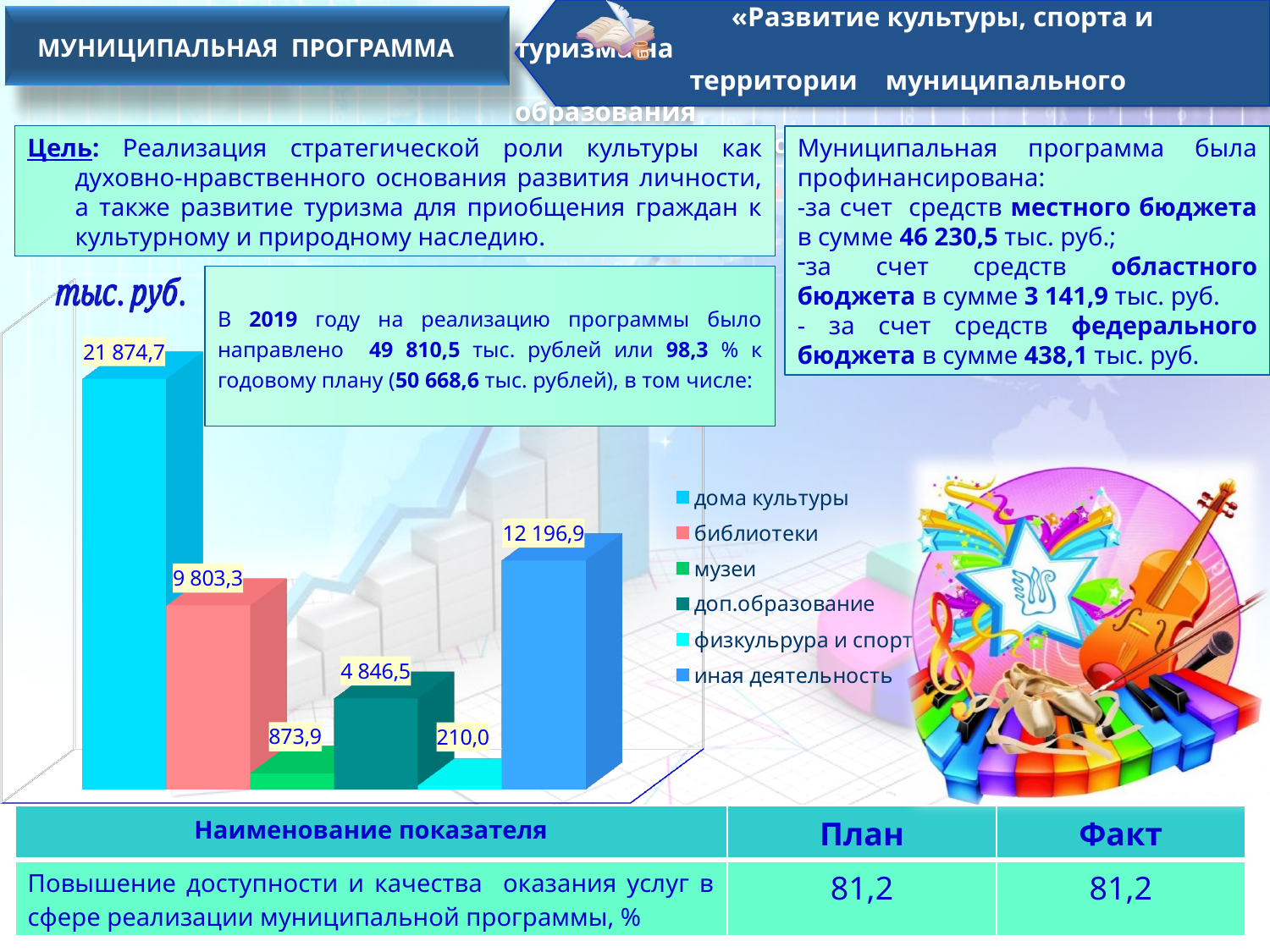
What value is shown for библиотеки on the chart? 9 803,3 Which category has the lowest value on the chart? физкульрура и спорт What value is shown for физкульрура и спорт on the chart? 210,0 What kind of chart is shown on the slide? bar chart What value is shown for иная деятельность on the chart? 12 196,9 What is the difference between the values for дома культуры and иная деятельность? 9 677,8 What value is shown for доп.образование on the chart? 4 846,5 Which category has the highest value on the chart? дома культуры How many entries does the chart legend list? 6 Which is larger, the value for библиотеки or the value for доп.образование? библиотеки What value is shown for музеи on the chart? 873,9 What value is shown for дома культуры on the chart? 21 874,7